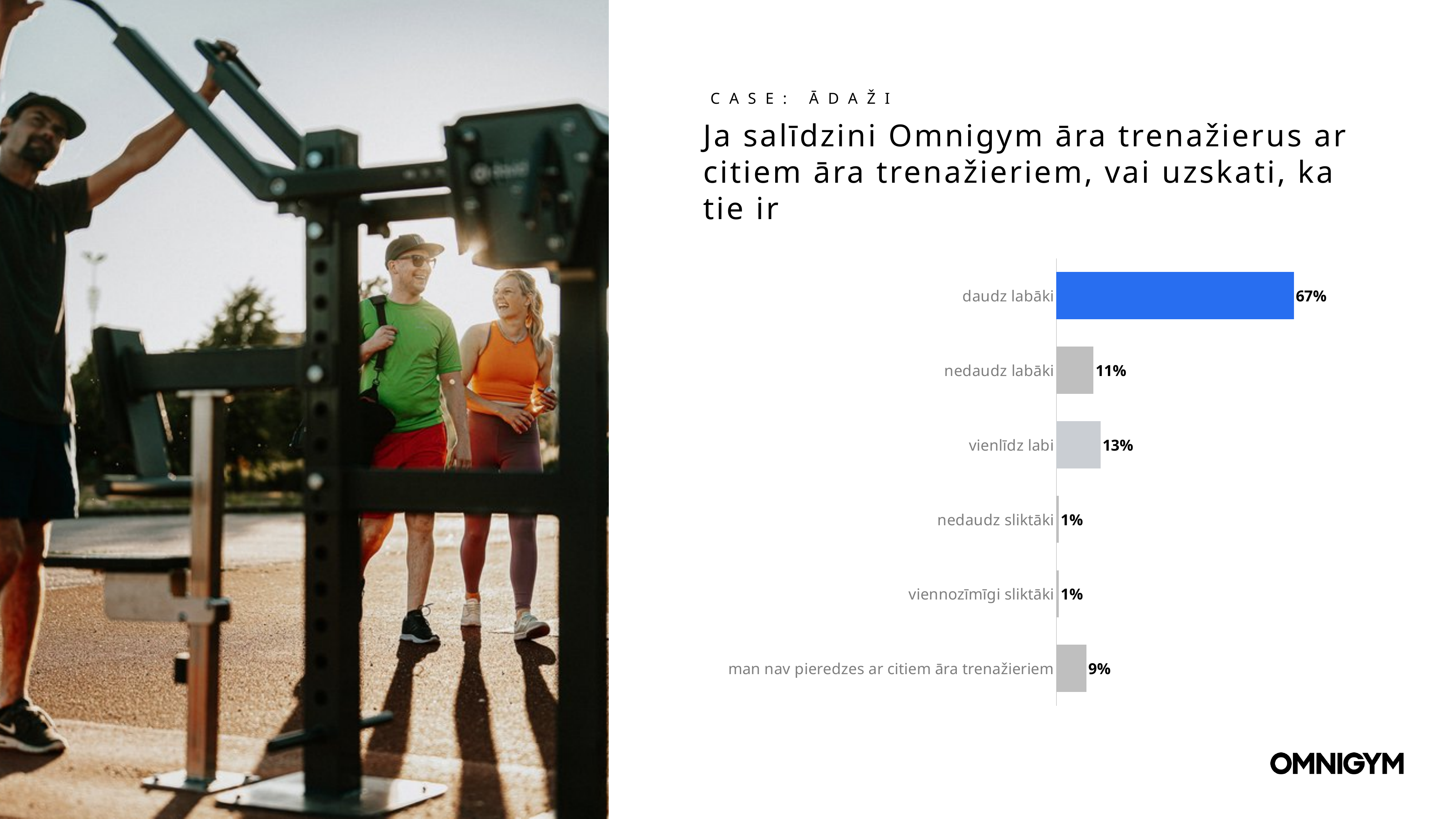
What is the value for "man nav pieredzes ar citiem āra trenažieriem"? 9% What is the value for "nedaudz sliktāki"? 1% What is the value for "vienlīdz labi"? 13% What is the difference between "daudz labāki" and "vienlīdz labi"? 54% Which is larger, "nedaudz labāki" or "man nav pieredzes ar citiem āra trenažieriem"? nedaudz labāki What is the value for "daudz labāki"? 67% Which category has the highest value? daudz labāki What is the difference between "vienlīdz labi" and "nedaudz labāki"? 2% What is the value for "nedaudz labāki"? 11% Which bar is coloured blue rather than grey? daudz labāki How many categories are shown in the chart? 6 What kind of chart is shown on the slide? bar chart